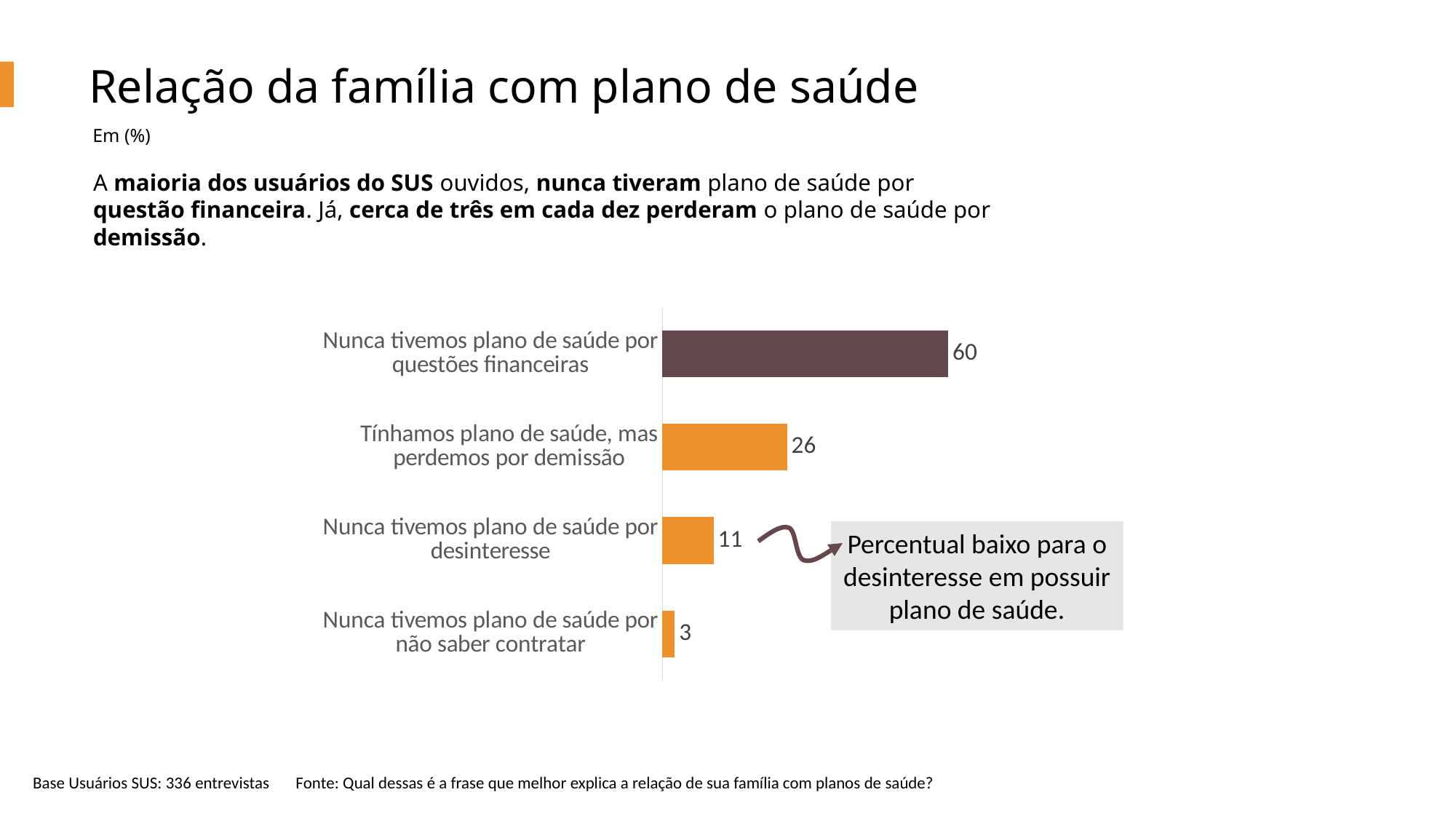
Which category has the lowest value? Nunca tivemos plano de saúde por não saber contratar What is the value for "Nunca tivemos plano de saúde por questões financeiras"? 60 What is the value for "Nunca tivemos plano de saúde por não saber contratar"? 3 Which category has the highest value? Nunca tivemos plano de saúde por questões financeiras What is the value for "Nunca tivemos plano de saúde por desinteresse"? 11 What is the value for "Tínhamos plano de saúde, mas perdemos por demissão"? 26 Which is larger: the value for "perdemos por demissão" or the value for "desinteresse"? perdemos por demissão How many categories are shown in the chart? 4 What is the difference between the values for "questões financeiras" and "perdemos por demissão"? 34 What does the callout box next to the "desinteresse" bar say? Percentual baixo para o desinteresse em possuir plano de saúde. What is the difference between the values for "desinteresse" and "não saber contratar"? 8 What kind of chart is shown on the slide? bar chart